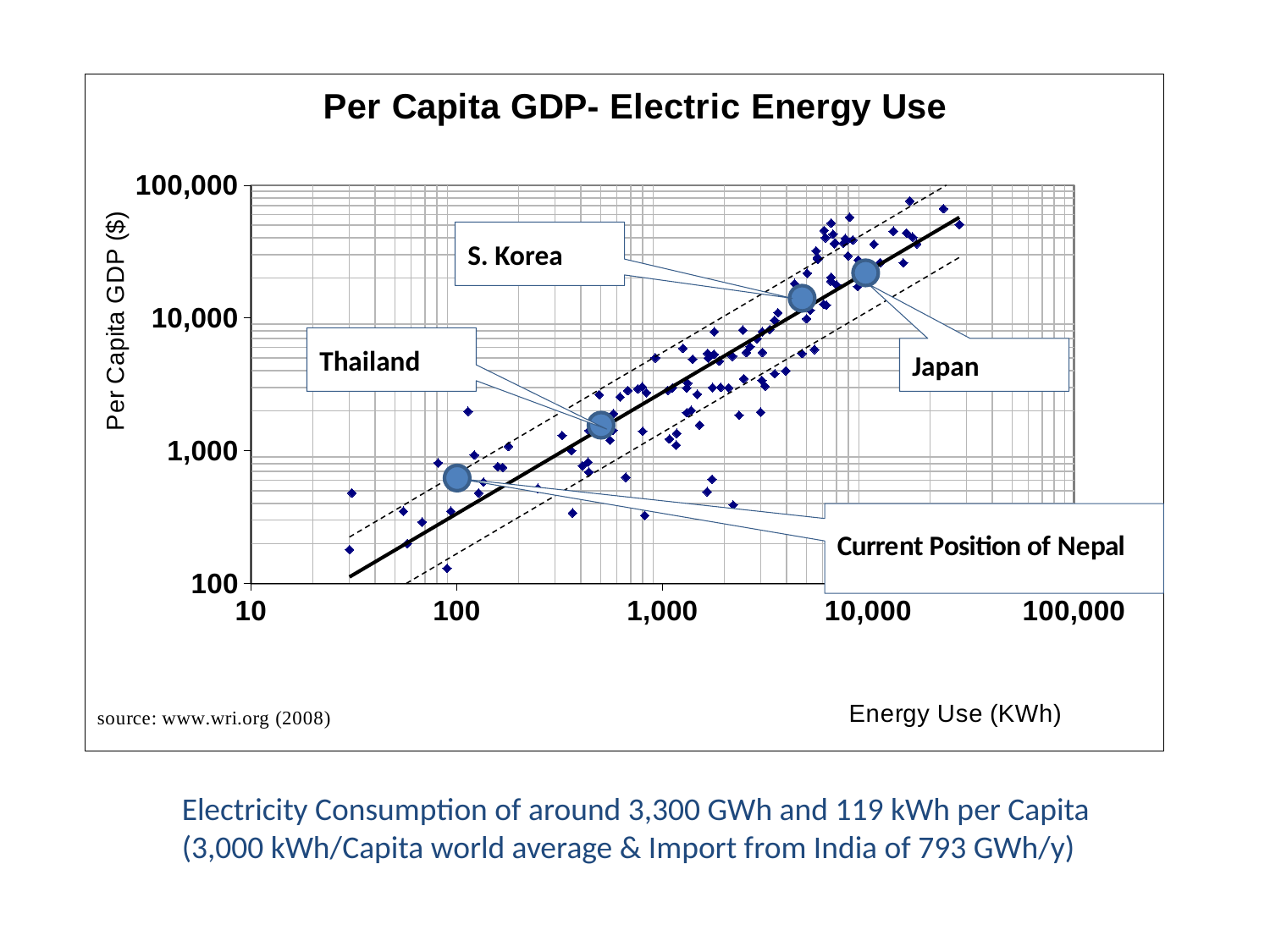
How many countries are labelled with callouts on the chart? 4 Among the labelled countries, which has the lowest per capita GDP? Current Position of Nepal Is the per capita GDP for the Current Position of Nepal greater or less than 1,000? less Is the energy use for Thailand greater or less than 1,000 KWh? less Is the per capita GDP for Japan greater or less than 10,000? greater What is the label of the vertical axis of the chart? Per Capita GDP ($) Which has the higher energy use, Japan or S. Korea? Japan What is the title of the chart? Per Capita GDP- Electric Energy Use Does per capita GDP generally rise or fall as energy use increases along the x axis? rise What kind of chart is shown on the slide? scatter chart Among the labelled countries, which has the highest per capita GDP? Japan